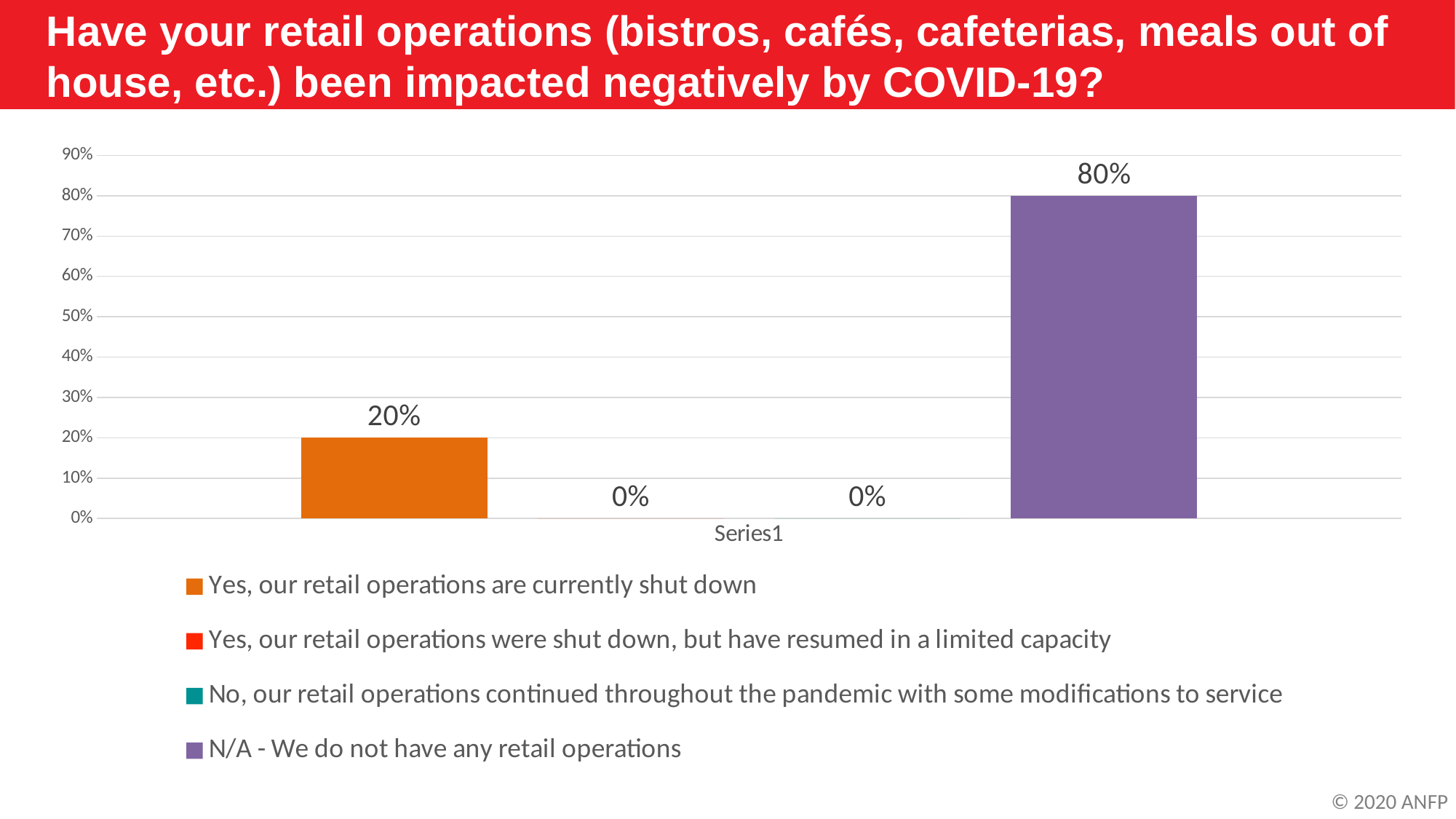
What kind of chart is shown on the slide? bar chart Is the value for 'N/A - We do not have any retail operations' greater or less than 50%? greater How many response options does the legend list? 4 What percentage of respondents answered 'N/A - We do not have any retail operations'? 80% What percentage of respondents said their retail operations continued throughout the pandemic with some modifications to service? 0% Which is larger: the value for 'Yes, our retail operations are currently shut down' or the value for 'N/A - We do not have any retail operations'? N/A - We do not have any retail operations What is the highest value shown on the vertical axis? 90% What colour is the bar for 'N/A - We do not have any retail operations'? purple What is the difference in percentage points between 'N/A - We do not have any retail operations' and 'Yes, our retail operations are currently shut down'? 60% What percentage of respondents said their retail operations were shut down but have resumed in a limited capacity? 0% Which response option has the highest percentage? N/A - We do not have any retail operations What percentage of respondents said their retail operations are currently shut down? 20%